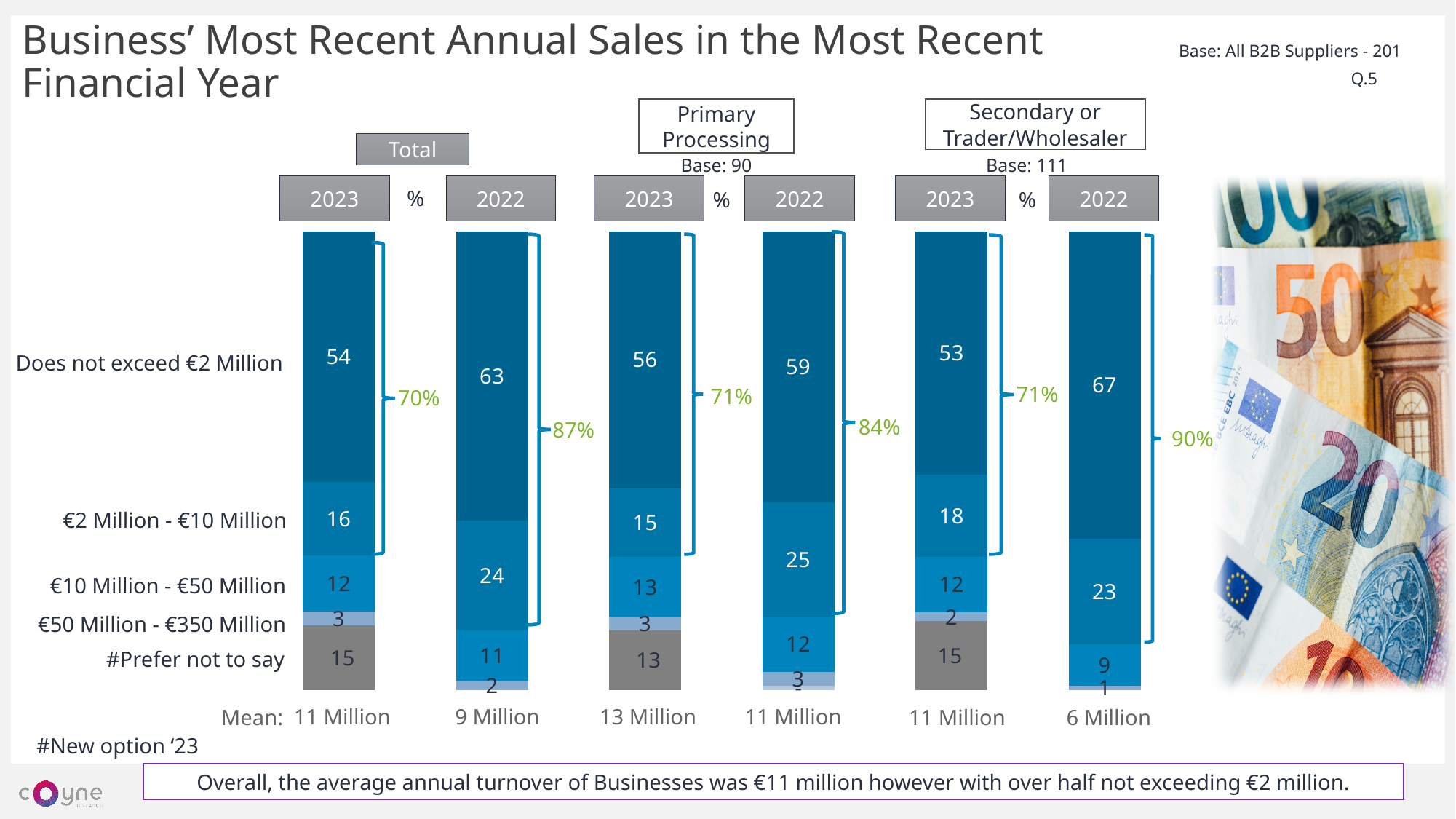
Which is larger: the '€2 Million - €10 Million' value for Primary Processing 2022 or for Primary Processing 2023? Primary Processing 2022 What is the difference between the 'Does not exceed €2 Million' values for Total 2022 and Total 2023? 9 How many sales categories are listed on the left of the chart? 5 In the Total 2023 bar, what percentage of businesses does not exceed €2 Million in annual sales? 54 In the Primary Processing 2023 bar, what is the value for '€2 Million - €10 Million'? 15 In the Secondary or Trader/Wholesaler 2022 bar, what is the value for 'Does not exceed €2 Million'? 67 What is the base shown for the Primary Processing group? Base: 90 What type of chart is used on this slide? Stacked bar chart Across the six bars, which has the highest value for 'Does not exceed €2 Million'? Secondary or Trader/Wholesaler 2022 What is the bracketed combined percentage shown for the Secondary or Trader/Wholesaler 2022 bar? 90% Which bar shows the lowest mean annual sales? Secondary or Trader/Wholesaler 2022 (6 Million) What is the mean annual sales shown for Primary Processing in 2023? 13 Million